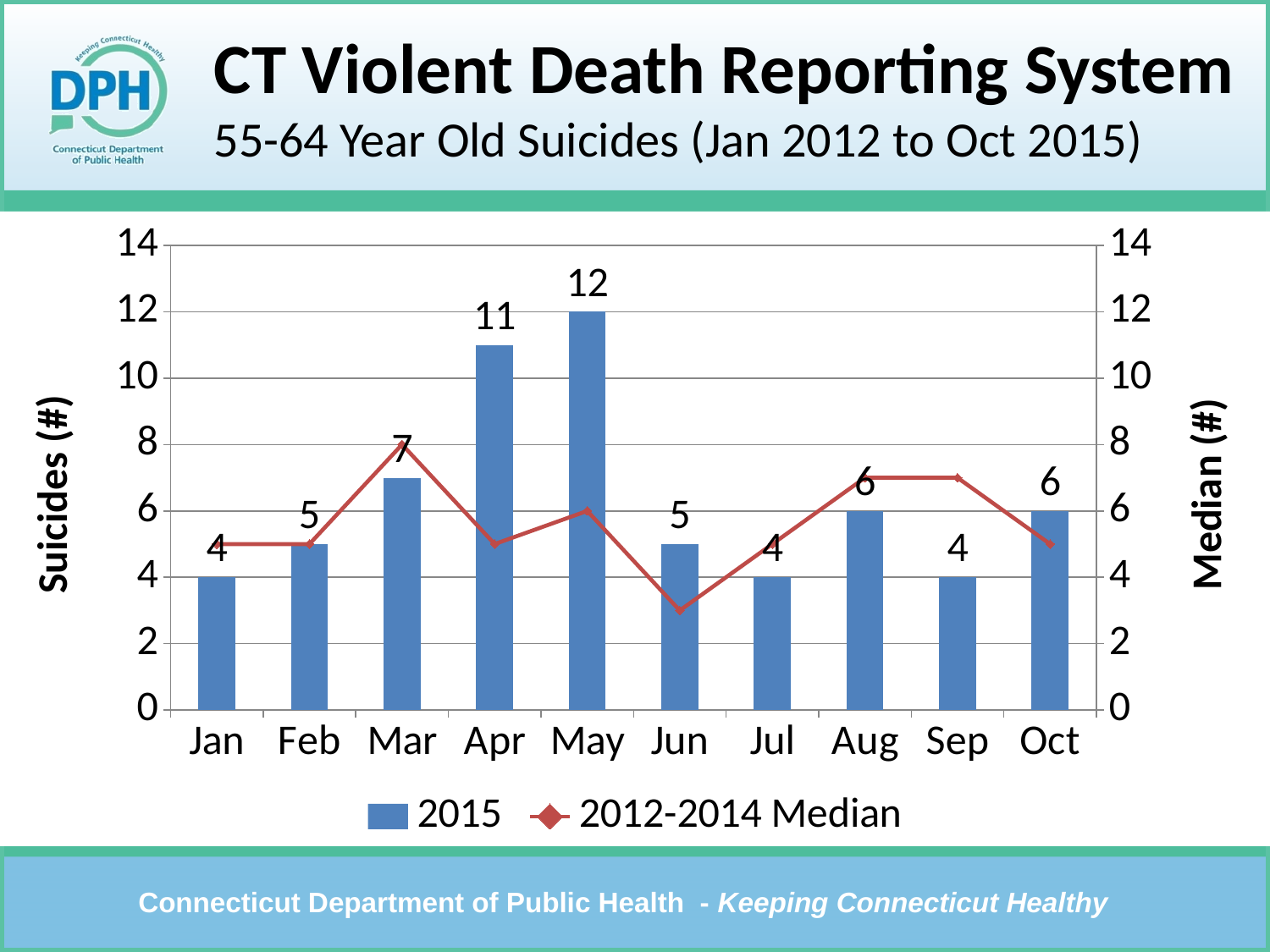
What is the 2015 value for Apr? 11 What is the difference between the 2015 values for May and Jan? 8 Which month has the highest 2015 value? May Which is larger, the 2015 value for Aug or the 2015 value for Sep? Aug What is the label of the left vertical axis? Suicides (#) Is the 2012-2014 Median value for Aug greater or less than 6? greater What kind of chart is used for the 2015 series? bar chart Is the 2012-2014 Median value for Jun greater or less than 4? less How many series does the legend list? 2 What is the 2015 value for May? 12 What is the 2015 value for Mar? 7 How many months are shown on the x axis? 10